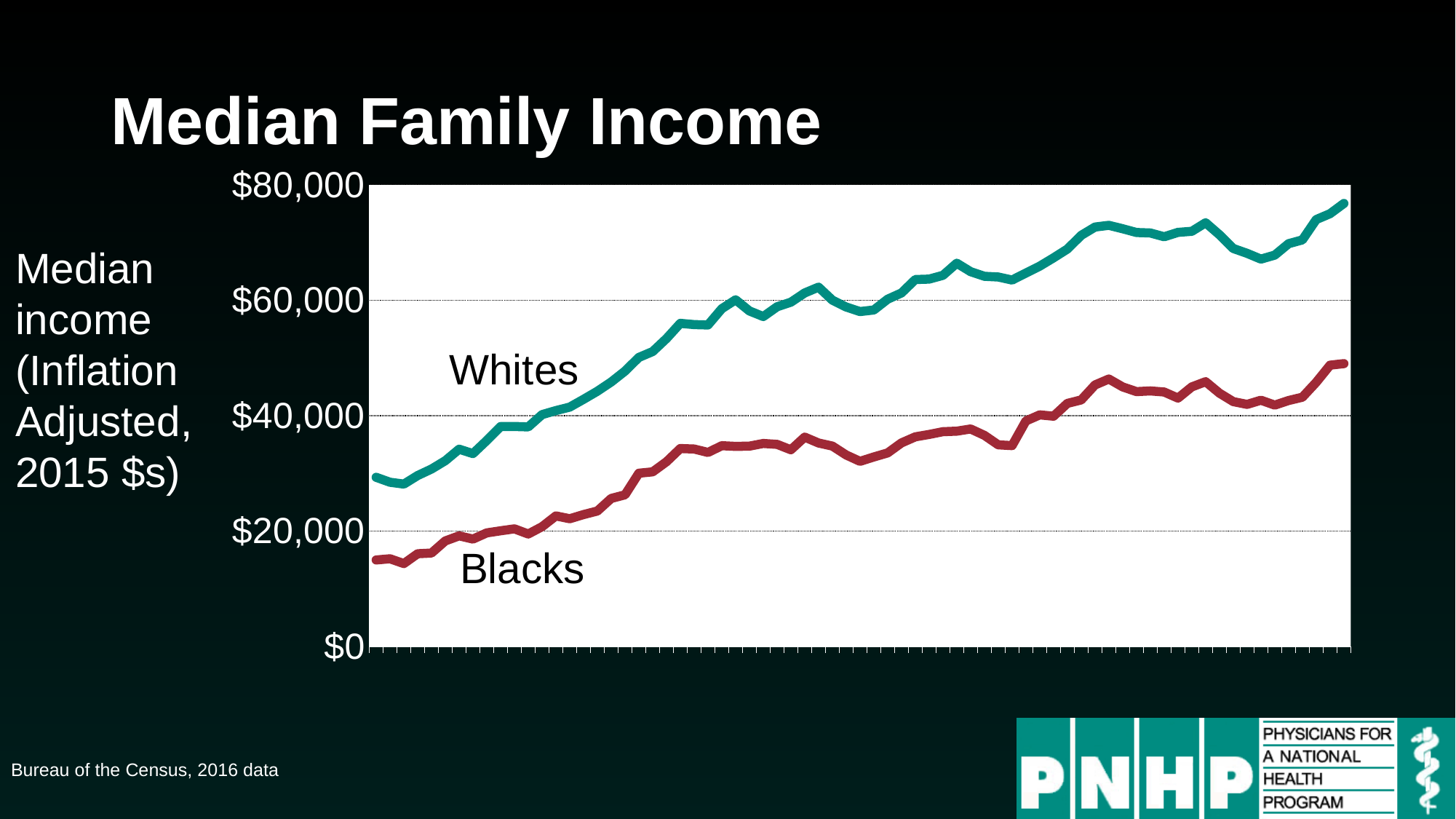
How many data series are plotted on the chart? 2 Which series is higher throughout the chart, Whites or Blacks? Whites Does the Blacks series generally rise or fall from left to right across the chart? rise What is the highest value shown on the vertical axis of the chart? $80,000 What kind of chart is shown on the slide? line chart Is the value for Whites at the left end of the chart greater or less than $20,000? greater Is the value for Whites at the right end of the chart greater or less than $60,000? greater Does the Blacks series ever reach $60,000 on the chart? No What is the title of the chart on the slide? Median Family Income Does the Whites series generally rise or fall from left to right across the chart? rise